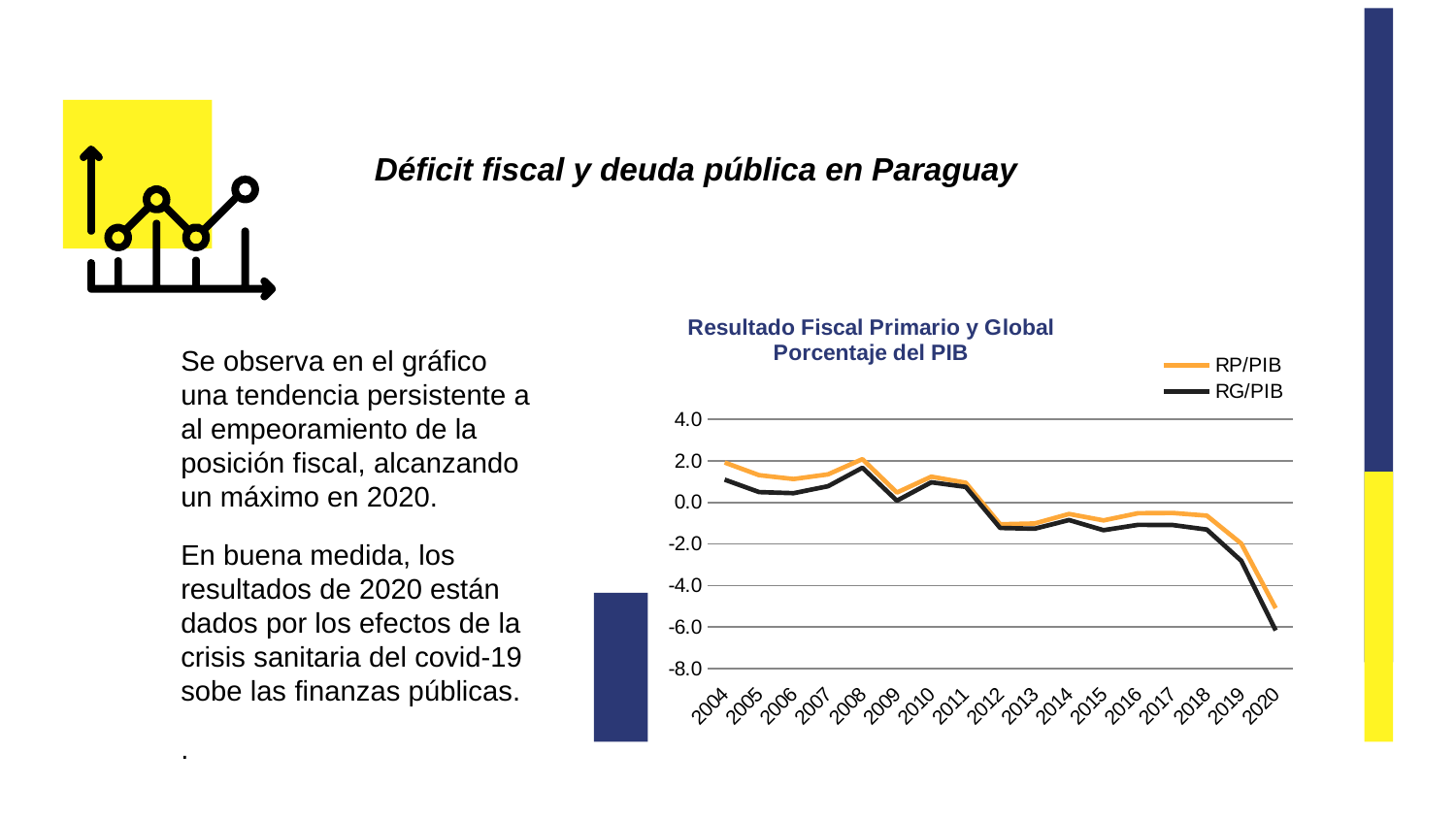
How many years are plotted along the x axis of the chart? 17 How many series does the chart legend list? 2 In which year does the RG/PIB series reach its highest value? 2008 Is the value for RP/PIB in 2020 greater or less than -4.0? less Is the value for RG/PIB in 2004 greater or less than 0.0? greater In which year does the RP/PIB series reach its lowest value? 2020 What kind of chart is shown on the slide? line chart In which year does the RG/PIB series reach its lowest value? 2020 Is the value for RG/PIB in 2019 greater or less than -2.0? less Which series is drawn in orange in the chart? RP/PIB In 2020, which series has the higher value, RP/PIB or RG/PIB? RP/PIB Do the values of the RG/PIB series generally rise or fall from 2004 to 2020? fall